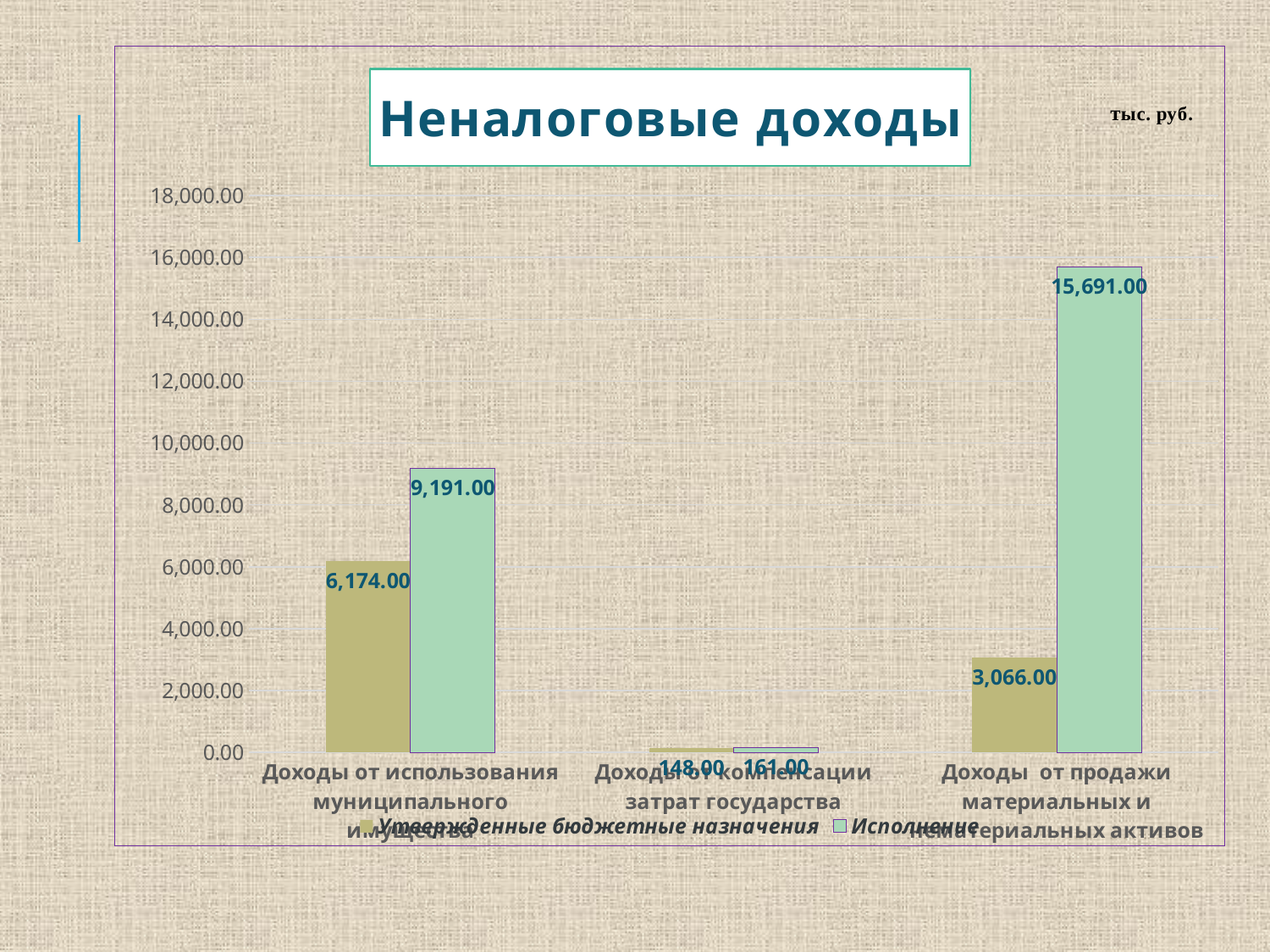
What type of chart is shown on the slide? bar chart What is the difference between 'Исполнение' and 'Утвержденные бюджетные назначения' for 'Доходы от использования муниципального имущества'? 3,017.00 Which category has the lowest 'Утвержденные бюджетные назначения' value? Доходы от компенсации затрат государства What unit is indicated in the top right corner of the chart? тыс. руб. What is the value of 'Исполнение' for 'Доходы от продажи материальных и нематериальных активов'? 15,691.00 What is the value of 'Исполнение' for 'Доходы от компенсации затрат государства'? 161.00 Which is larger for 'Доходы от продажи материальных и нематериальных активов': 'Утвержденные бюджетные назначения' or 'Исполнение'? Исполнение What is the value of 'Утвержденные бюджетные назначения' for 'Доходы от использования муниципального имущества'? 6,174.00 How many series does the legend list? 2 Which category has the highest 'Исполнение' value? Доходы от продажи материальных и нематериальных активов What is the chart's title? Неналоговые доходы How many categories are shown on the x axis? 3